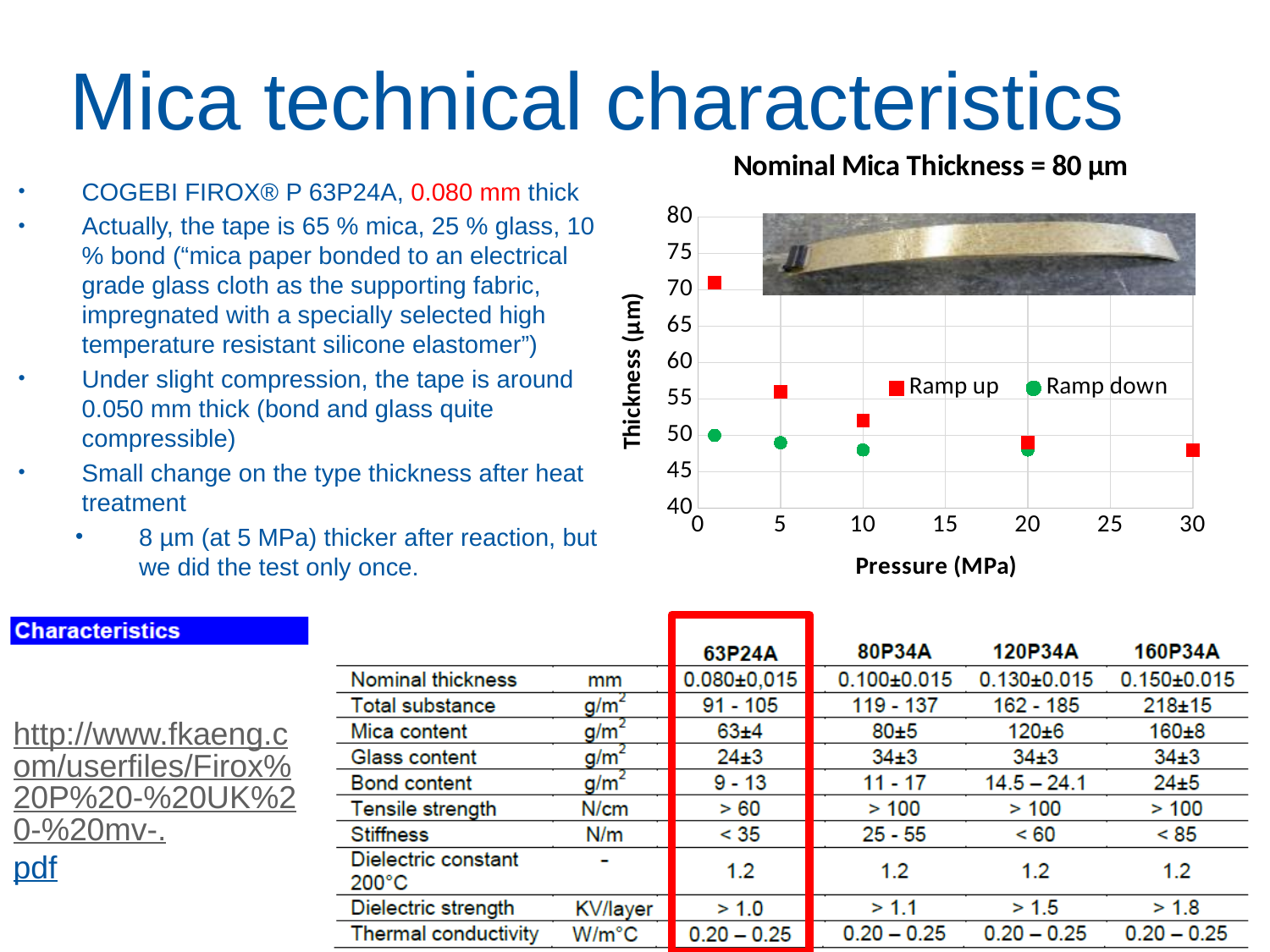
What kind of chart is shown on the slide? scatter chart Is the Ramp up thickness at 5 MPa greater or less than 50 μm? greater How many series does the chart legend list? 2 What is the title of the chart? Nominal Mica Thickness = 80 μm Is the Ramp down thickness at 10 MPa greater or less than 50 μm? less At 5 MPa, which series shows the larger thickness, Ramp up or Ramp down? Ramp up Do the Ramp up thickness values rise or fall as pressure increases? fall How many Ramp up points are plotted on the chart? 5 What are the two series named in the chart legend? Ramp up and Ramp down How many Ramp down points are plotted on the chart? 4 Is the Ramp up thickness at 30 MPa greater or less than 50 μm? less